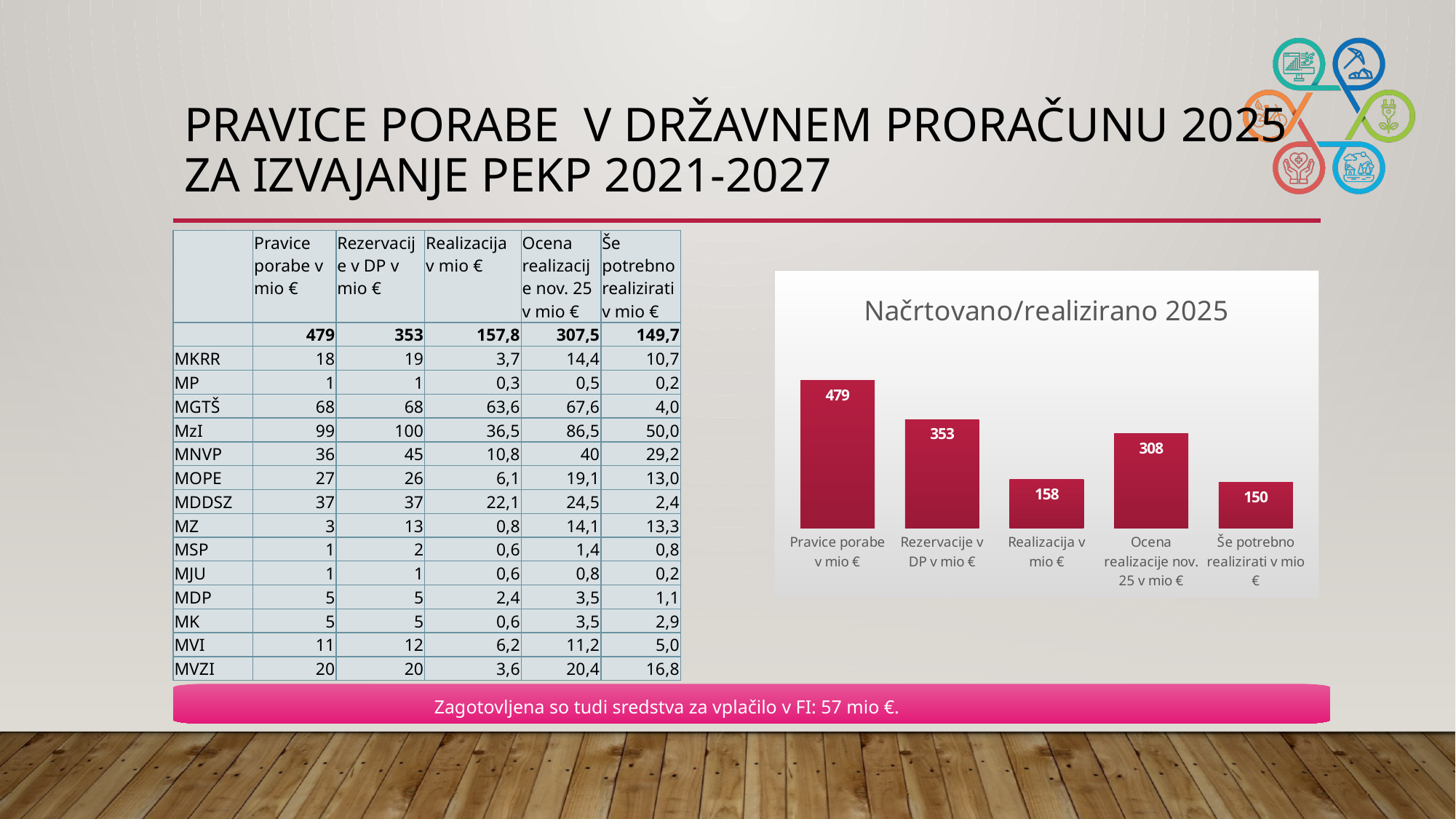
Which category has the lowest value in the chart? Še potrebno realizirati v mio € What is the value of the bar labelled 'Rezervacije v DP v mio €'? 353 What is the title of the chart on the slide? Načrtovano/realizirano 2025 What is the difference between the 'Pravice porabe v mio €' bar and the 'Rezervacije v DP v mio €' bar? 126 What is the value of the bar labelled 'Še potrebno realizirati v mio €'? 150 What is the value of the bar labelled 'Ocena realizacije nov. 25 v mio €'? 308 What is the value of the bar labelled 'Pravice porabe v mio €'? 479 How many bars does the chart show? 5 What is the value of the bar labelled 'Realizacija v mio €'? 158 Which is larger, 'Ocena realizacije nov. 25 v mio €' or 'Realizacija v mio €'? Ocena realizacije nov. 25 v mio € What type of chart is shown on the slide? bar chart Which category has the highest value in the chart? Pravice porabe v mio €